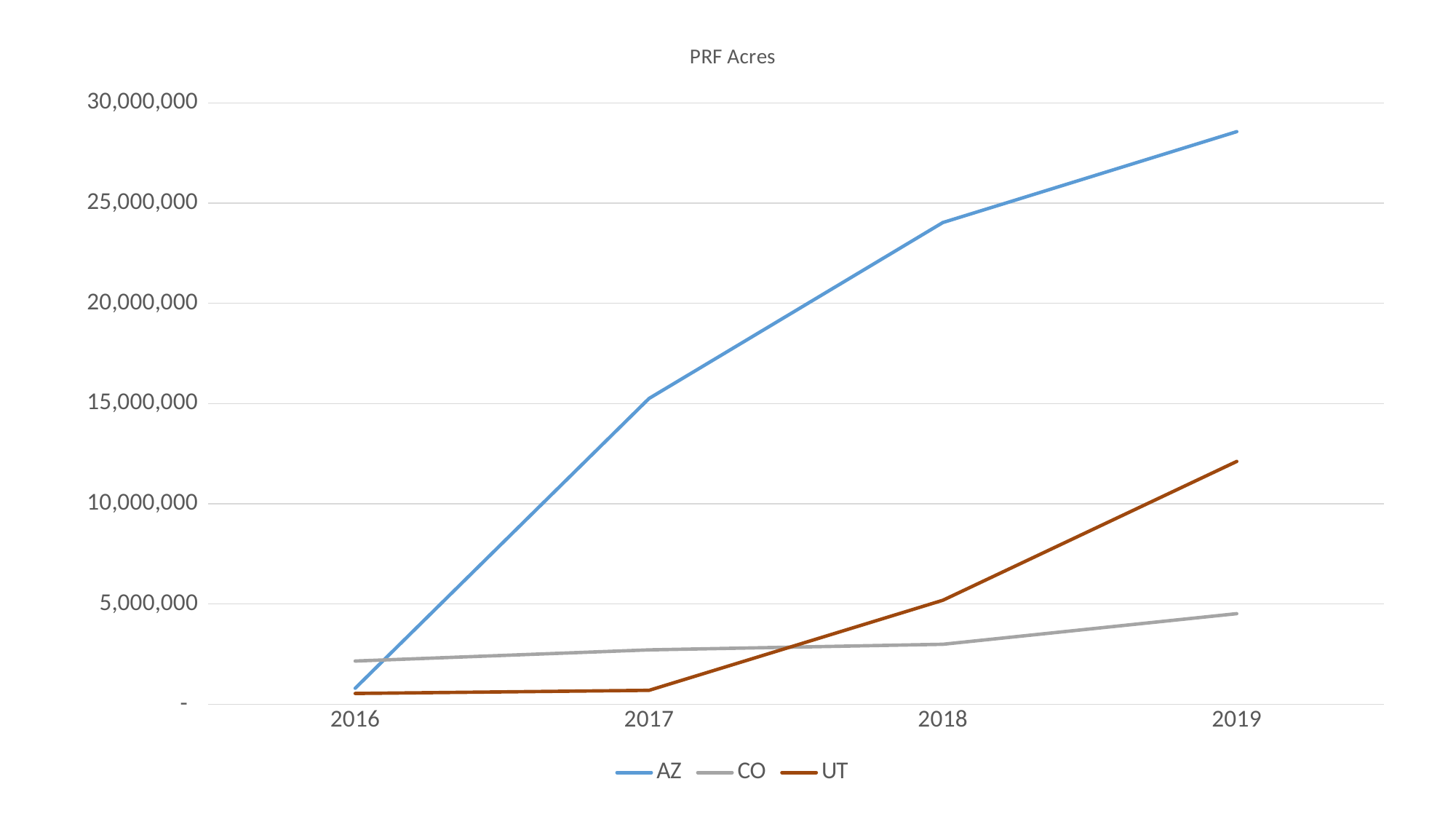
Is the value for AZ in 2019 greater or less than 25,000,000? greater Is the value for CO in 2019 greater or less than 5,000,000? less Which is larger in 2018, the value for UT or the value for CO? UT What is the title of the chart? PRF Acres Which series is drawn in blue? AZ What kind of chart is shown on the slide? line chart Which series has the lowest value in 2017? UT Which series has the highest value in 2019? AZ How many series does the legend list? 3 Does the AZ series rise or fall from 2016 to 2019? rise How many years are shown on the x axis? 4 Is the value for UT in 2019 greater or less than 10,000,000? greater